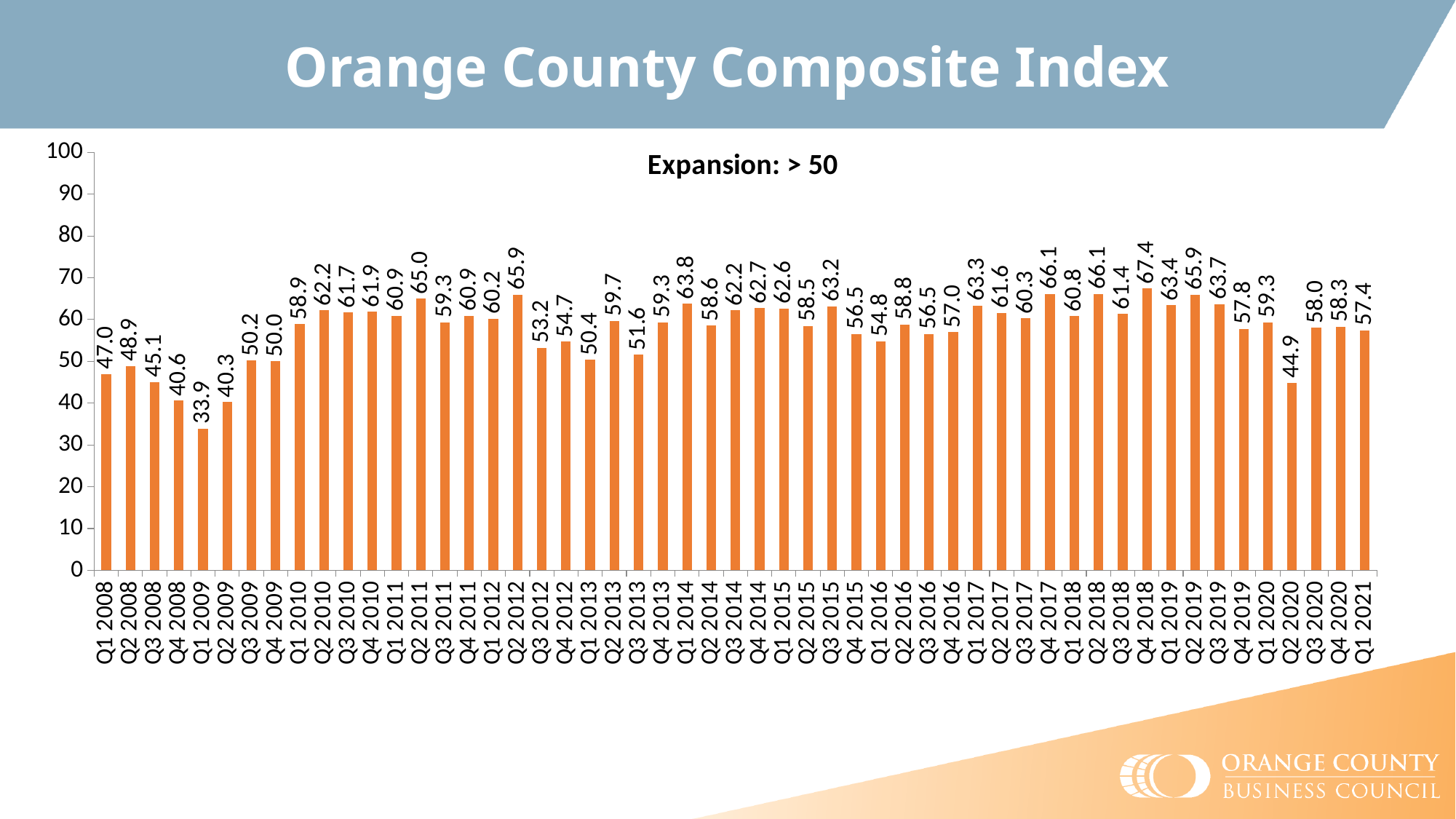
Is the value for Q2 2020 greater or less than 50? less Which quarter has the highest value of the Orange County Composite Index? Q4 2018 What threshold does the chart annotation give for expansion? > 50 Which is larger, the value for Q2 2012 or the value for Q2 2011? Q2 2012 Which quarter has the lowest value of the Orange County Composite Index? Q1 2009 Do the values rise or fall from Q1 2008 to Q1 2009? fall How many quarters are plotted on the chart? 53 What is the value of the Orange County Composite Index for Q1 2009? 33.9 What is the value of the Orange County Composite Index for Q2 2020? 44.9 What kind of chart is shown on the slide? bar chart What is the value of the Orange County Composite Index for Q1 2021? 57.4 What is the difference between the Q4 2018 value and the Q1 2009 value? 33.5